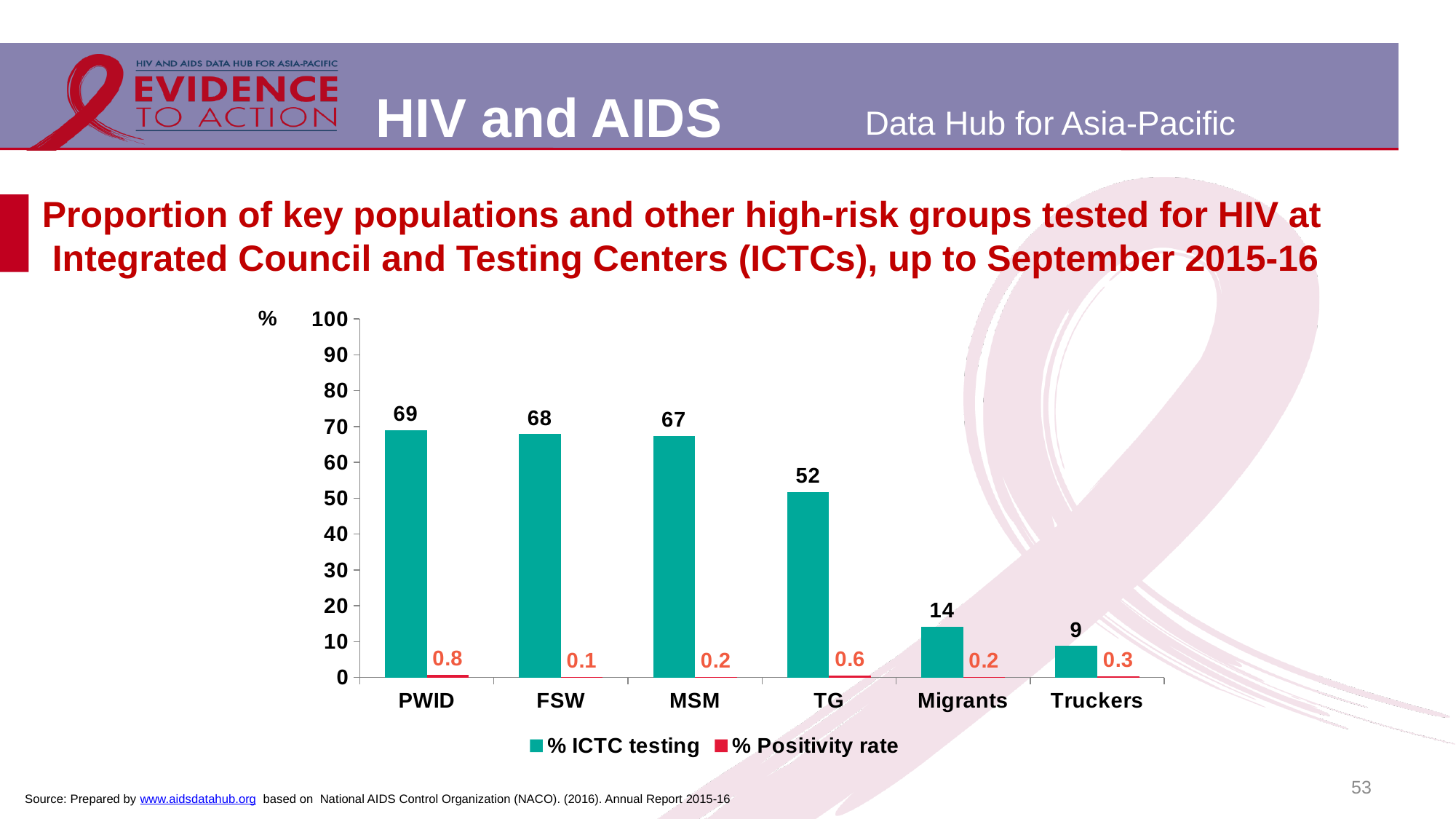
What is the % ICTC testing value for PWID? 69 Which has a higher % ICTC testing value, FSW or Migrants? FSW What is the difference in % ICTC testing between MSM and TG? 15 How many series does the legend list? 2 What is the % Positivity rate for TG? 0.6 What colour are the % ICTC testing bars? Teal What is the % ICTC testing value for Migrants? 14 Which group has the highest % ICTC testing value? PWID Which group has the highest % Positivity rate? PWID Which group has the lowest % ICTC testing value? Truckers How many groups are shown on the x axis? 6 What kind of chart is shown on the slide? Bar chart